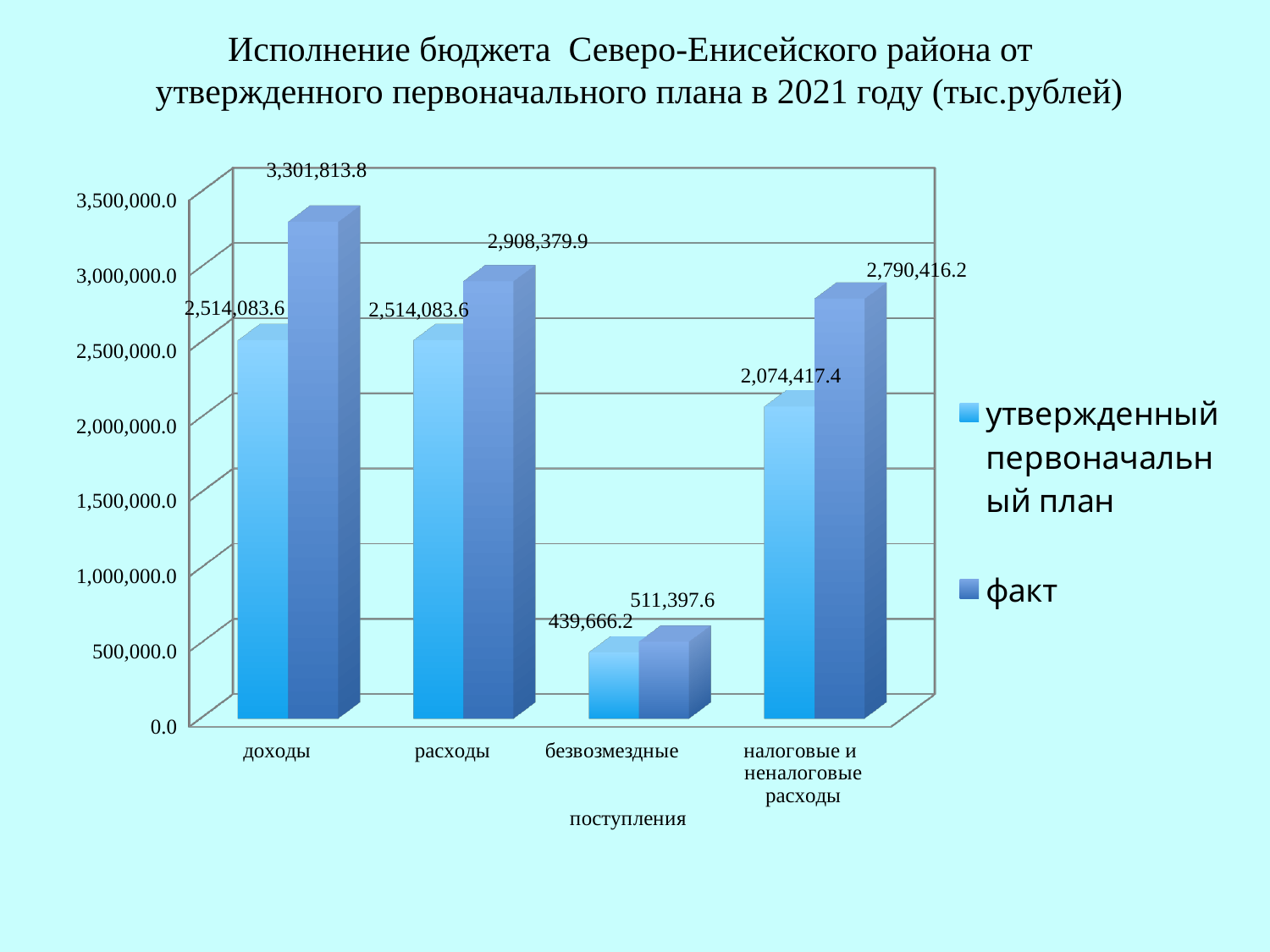
What type of chart is shown on the slide? bar chart What is the value of "утвержденный первоначальный план" for "налоговые и неналоговые расходы"? 2,074,417.4 What is the value of "факт" for "доходы"? 3,301,813.8 What is the value of "факт" for "безвозмездные поступления"? 511,397.6 How many series does the legend list? 2 What is the difference between "факт" and "утвержденный первоначальный план" for "расходы"? 394,296.3 What is the difference between "факт" and "утвержденный первоначальный план" for "доходы"? 787,730.2 Which category has the lowest "утвержденный первоначальный план" value? безвозмездные поступления What is the second series listed in the legend? факт Which category has the highest "факт" value? доходы Which is larger for "налоговые и неналоговые расходы": "утвержденный первоначальный план" or "факт"? факт How many categories are shown on the x axis? 4